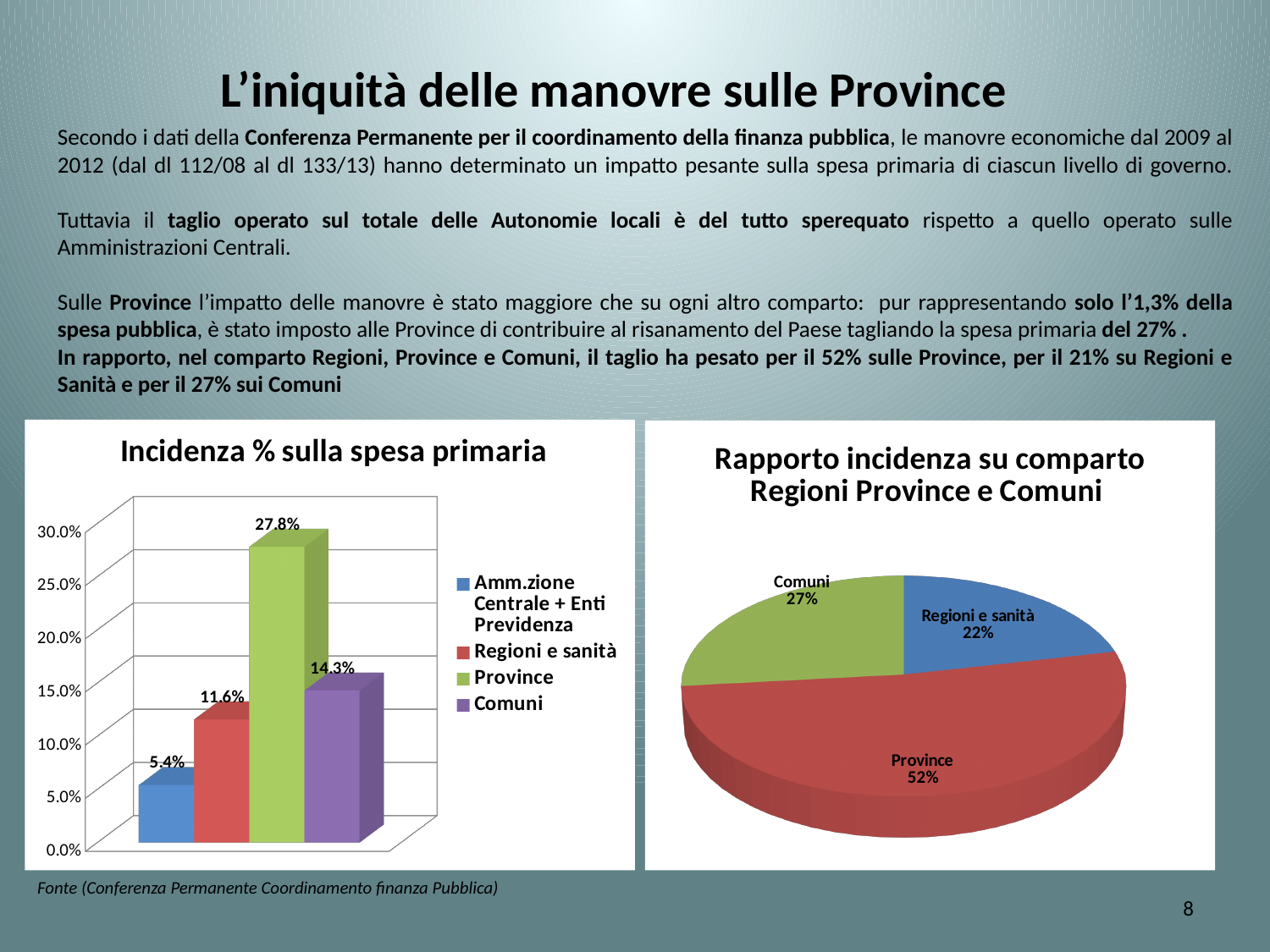
In the 'Incidenza % sulla spesa primaria' chart, which is larger: Regioni e sanità or Comuni? Comuni In the 'Incidenza % sulla spesa primaria' chart, what is the value for Comuni? 14.3% How many slices does the 'Rapporto incidenza su comparto Regioni Province e Comuni' pie chart have? 3 In the 'Incidenza % sulla spesa primaria' chart, what is the value for Amm.zione Centrale + Enti Previdenza? 5.4% In the 'Incidenza % sulla spesa primaria' chart, what is the value for Province? 27.8% In the 'Incidenza % sulla spesa primaria' chart, what is the difference between the values for Province and Comuni? 13.5% In the 'Incidenza % sulla spesa primaria' chart, which series has the highest value? Province How many series does the legend of the 'Incidenza % sulla spesa primaria' chart list? 4 What kind of chart is 'Rapporto incidenza su comparto Regioni Province e Comuni'? Pie chart In the 'Rapporto incidenza su comparto Regioni Province e Comuni' pie chart, what share does Province have? 52% In the 'Rapporto incidenza su comparto Regioni Province e Comuni' pie chart, which slice is the smallest? Regioni e sanità In the 'Incidenza % sulla spesa primaria' chart, which series has the lowest value? Amm.zione Centrale + Enti Previdenza